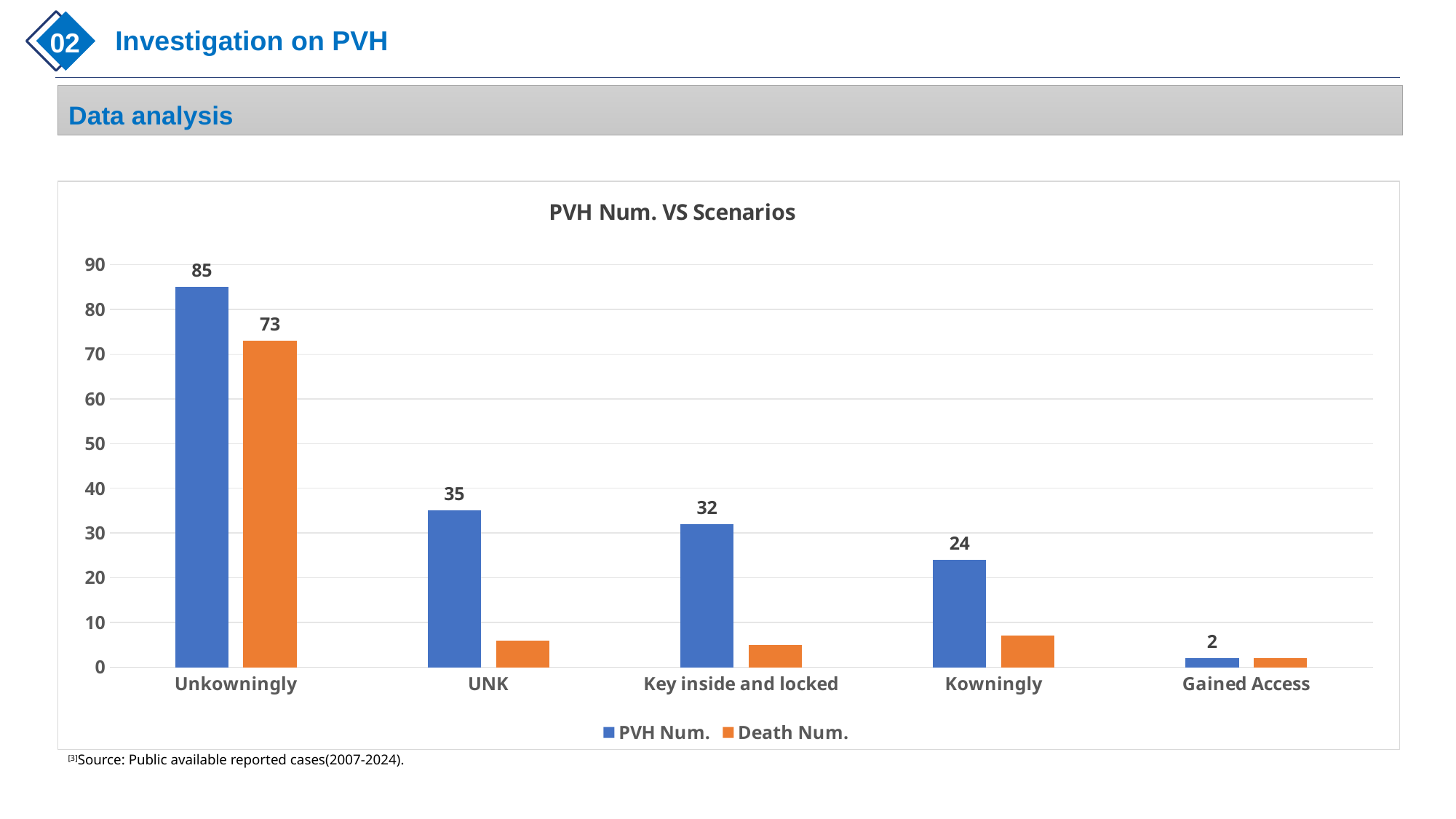
What is the PVH Num. value for Key inside and locked? 32 What is the title of the chart? PVH Num. VS Scenarios What is the PVH Num. value for Unkowningly? 85 Which category has the highest PVH Num. value? Unkowningly How many scenario categories are shown on the x axis? 5 How many series does the legend list? 2 Which category has the lowest PVH Num. value? Gained Access What is the Death Num. value for Unkowningly? 73 Is the Death Num. value for Kowningly greater or less than 10? less What is the difference between the PVH Num. and Death Num. values for Unkowningly? 12 What type of chart is shown on the slide? bar chart Which is larger, the PVH Num. value for UNK or the PVH Num. value for Kowningly? UNK